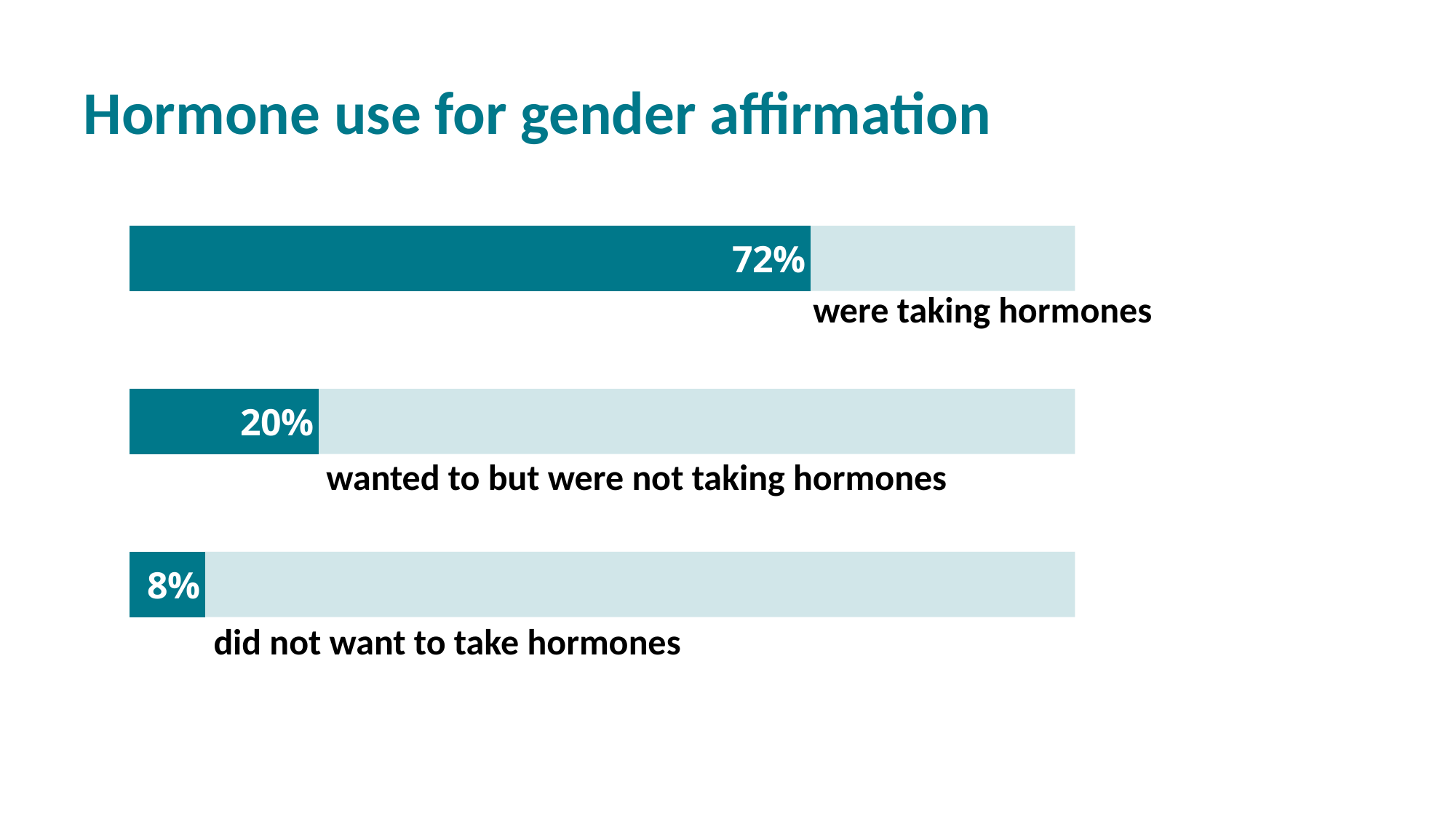
What percentage wanted to but were not taking hormones? 20% Which category has the highest percentage? were taking hormones What is the title of the slide? Hormone use for gender affirmation What is the difference between the percentage who wanted to but were not taking hormones and the percentage who did not want to take hormones? 12% What kind of chart is shown on the slide? bar chart Which is larger: the percentage who wanted to but were not taking hormones, or the percentage who did not want to take hormones? wanted to but were not taking hormones How many categories are shown in the chart? 3 What is the difference between the percentage who were taking hormones and the percentage who wanted to but were not taking hormones? 52% What is the total of the three percentages shown? 100% What percentage were taking hormones? 72% What percentage did not want to take hormones? 8% Which category has the lowest percentage? did not want to take hormones